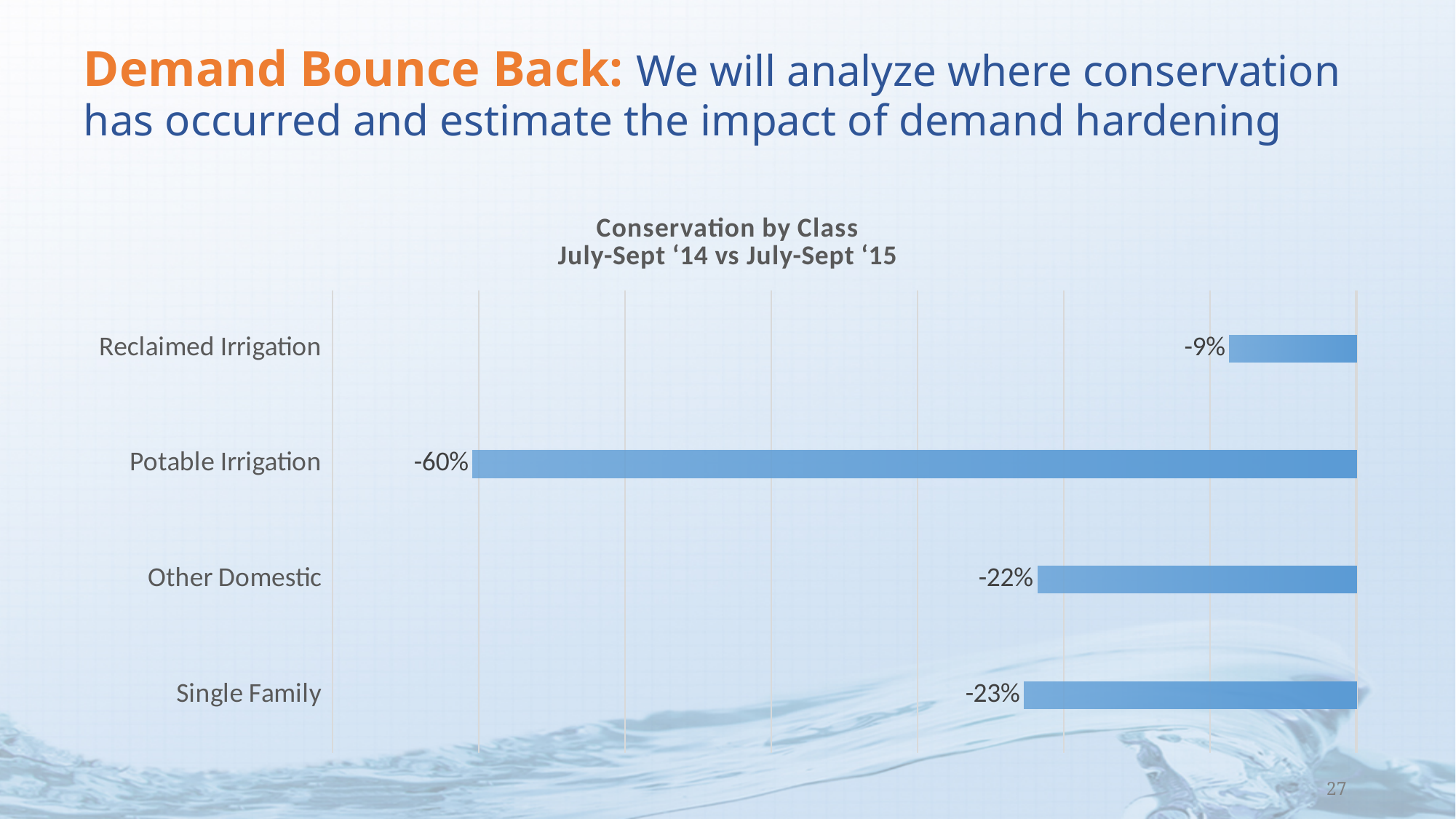
What is the value for Other Domestic? -22% Which class shows the smallest conservation (value closest to zero)? Reclaimed Irrigation Which class shows the largest conservation (most negative value)? Potable Irrigation What is the value for Single Family? -23% What is the difference in percentage points between the Potable Irrigation and Single Family values? 37 percentage points What kind of chart is shown on the slide? Bar chart What is the difference in percentage points between the Other Domestic and Reclaimed Irrigation values? 13 percentage points Which has the larger conservation reduction, Potable Irrigation or Other Domestic? Potable Irrigation What is the title of the chart? Conservation by Class July-Sept '14 vs July-Sept '15 How many classes are shown in the chart? 4 What is the value for Potable Irrigation? -60% What is the value for Reclaimed Irrigation? -9%